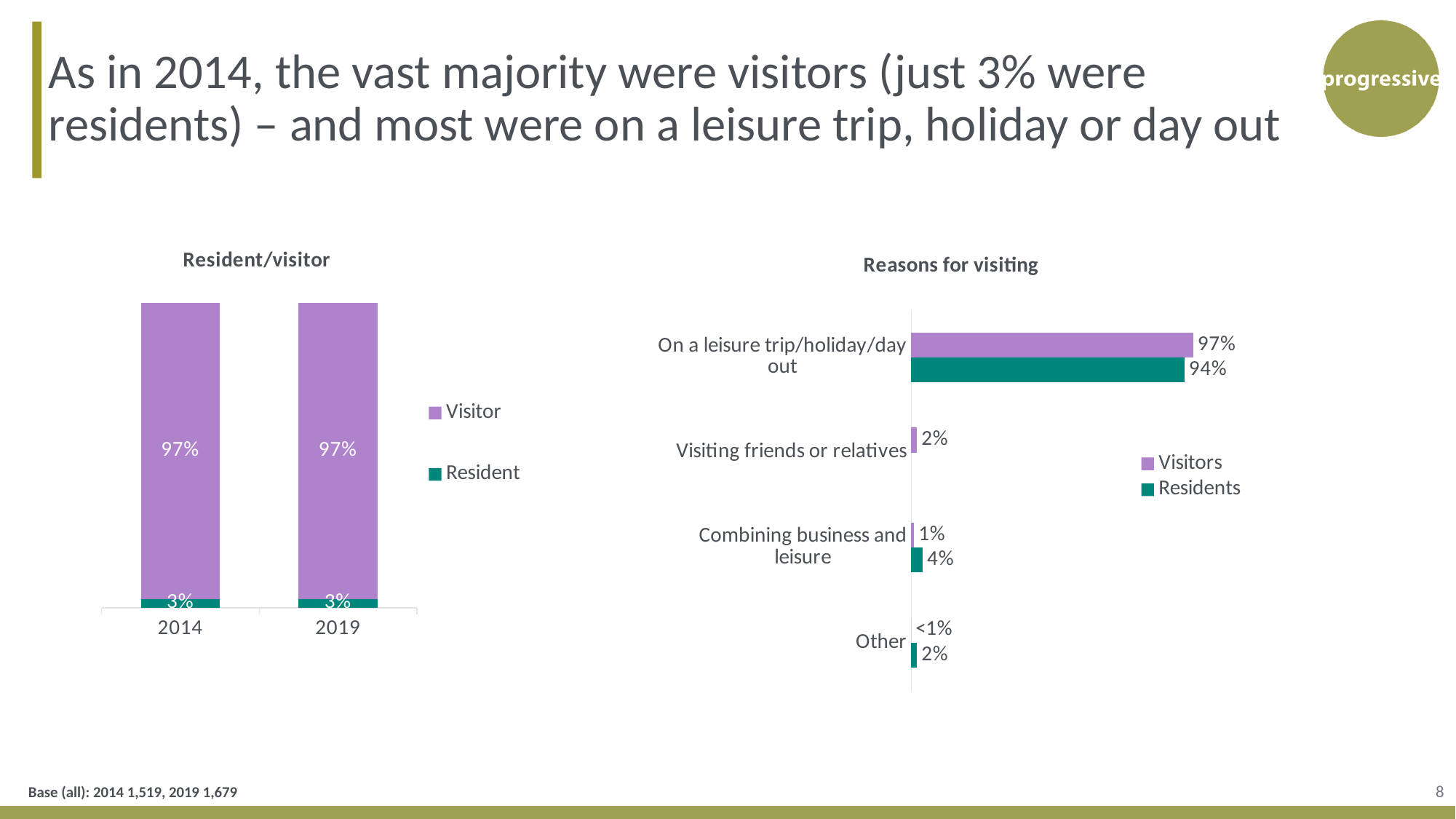
In the 'Reasons for visiting' chart, what is the difference between visitors and residents for 'On a leisure trip/holiday/day out'? 3 percentage points In the 'Reasons for visiting' chart, which reason has the highest value for visitors? On a leisure trip/holiday/day out In the 'Reasons for visiting' chart, what percentage of residents were combining business and leisure? 4% In the 'Resident/visitor' chart, what percentage were residents in 2014? 3% In the 'Resident/visitor' chart, what kind of chart is shown? Stacked bar chart In the 'Reasons for visiting' chart, what percentage of visitors were on a leisure trip/holiday/day out? 97% In the 'Reasons for visiting' chart, how many reason categories are shown? 4 In the 'Resident/visitor' chart, how many series does the legend list? 2 In the 'Resident/visitor' chart, what is the total of the stacked bar for 2019? 100% In the 'Resident/visitor' chart, what percentage were visitors in 2019? 97% In the 'Reasons for visiting' chart, what value is shown for visitors under 'Other'? <1% In the 'Reasons for visiting' chart, which is larger for 'Combining business and leisure': visitors or residents? Residents